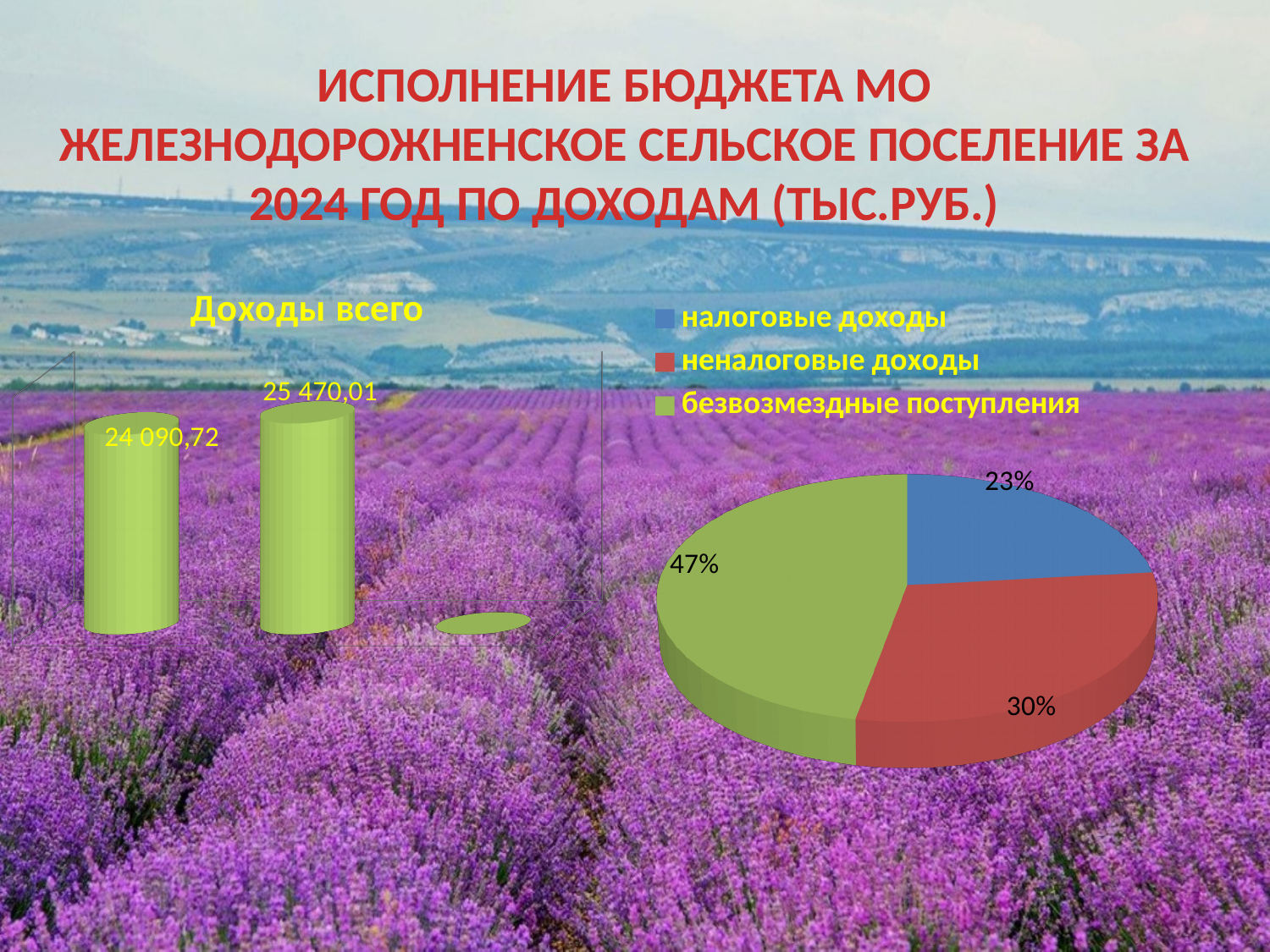
In the pie chart on the right, what share is shown for "безвозмездные поступления"? 47% In the pie chart on the right, which category has the smallest share? налоговые доходы In the pie chart on the right, how many percentage points larger is "безвозмездные поступления" than "налоговые доходы"? 24% In the bar chart titled "Доходы всего", which of the two labelled bars is larger, the first or the second? the second In the pie chart on the right, which category has the largest share? безвозмездные поступления In the pie chart on the right, what share is shown for "налоговые доходы"? 23% In the bar chart titled "Доходы всего", what is the value shown on the first (left) bar? 24 090,72 How many entries does the legend of the pie chart on the right list? 3 What kind of chart is the chart titled "Доходы всего"? bar chart In the bar chart titled "Доходы всего", what is the value shown on the second bar? 25 470,01 In the pie chart on the right, what share is shown for "неналоговые доходы"? 30% In the bar chart titled "Доходы всего", what is the difference between the second bar (25 470,01) and the first bar (24 090,72)? 1 379,29